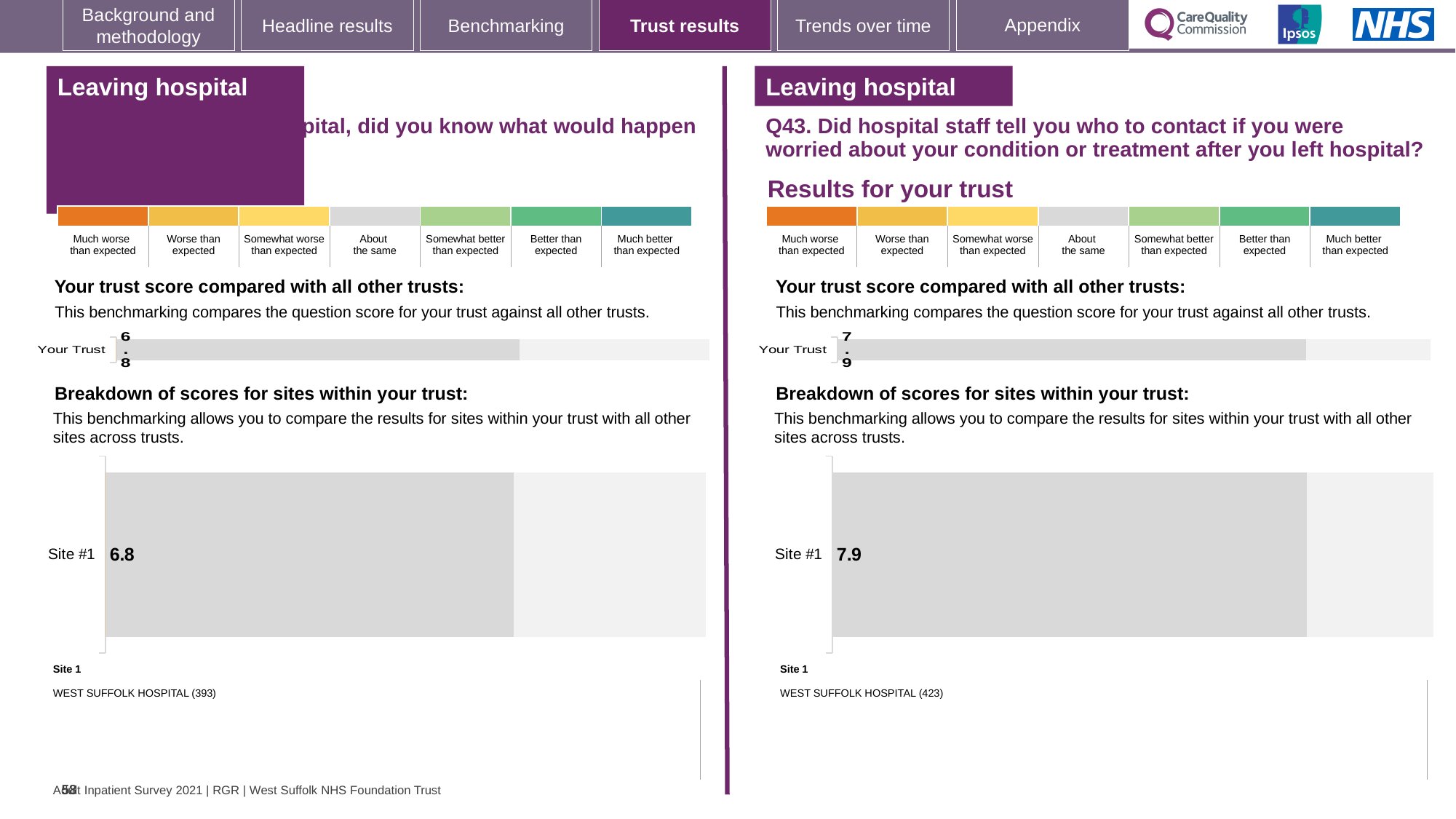
What is the difference between the Your Trust score on the right half of the slide (Q43) and the Your Trust score on the left half? 1.1 What type of chart is used for the 'Breakdown of scores for sites within your trust' on the right half of the slide? Bar chart On the left half of the slide, what score is shown for Site #1 in the 'Breakdown of scores for sites within your trust' chart? 6.8 On the right half of the slide (Q43), what score is shown for Site #1 in the 'Breakdown of scores for sites within your trust' chart? 7.9 Which is larger: the Site #1 score on the left half of the slide or the Site #1 score on the right half (Q43)? Right half (Q43), 7.9 On the right half of the slide (Q43), what is the score shown for Your Trust in the 'Your trust score compared with all other trusts' chart? 7.9 On the left half of the slide, which site name is listed as Site 1 below the breakdown chart? WEST SUFFOLK HOSPITAL (393) On the right half of the slide (Q43), which site name is listed as Site 1 below the breakdown chart? WEST SUFFOLK HOSPITAL (423) How many sites are plotted in the 'Breakdown of scores for sites within your trust' chart on the left half of the slide? 1 What is the difference between the Site #1 score on the right half of the slide (Q43) and the Site #1 score on the left half? 1.1 On the left half of the slide, what is the score shown for Your Trust in the 'Your trust score compared with all other trusts' chart? 6.8 How many sites are plotted in the 'Breakdown of scores for sites within your trust' chart on the right half of the slide (Q43)? 1